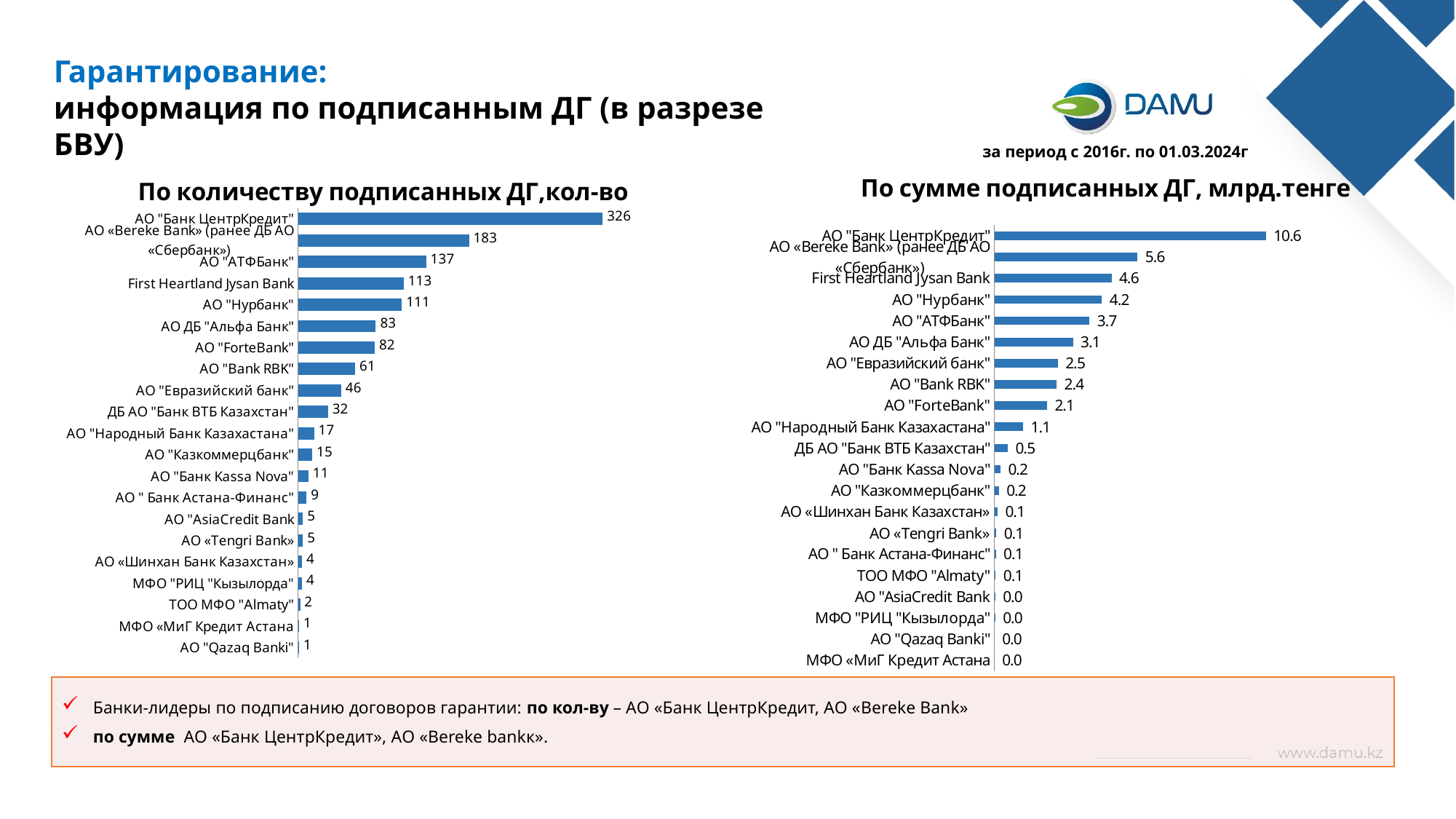
In the chart "По сумме подписанных ДГ, млрд.тенге", which is larger: АО "Евразийский банк" or АО "ForteBank"? АО "Евразийский банк" In the chart "По количеству подписанных ДГ,кол-во", what is the value for АО "АТФБанк"? 137 In the chart "По сумме подписанных ДГ, млрд.тенге", what is the value for АО "Народный Банк Казахастана"? 1.1 In the chart "По сумме подписанных ДГ, млрд.тенге", what is the difference between First Heartland Jysan Bank and АО "АТФБанк"? 0.9 In the chart "По количеству подписанных ДГ,кол-во", which is larger: АО ДБ "Альфа Банк" or АО "Bank RBK"? АО ДБ "Альфа Банк" What kind of chart is "По сумме подписанных ДГ, млрд.тенге"? Bar chart In the chart "По количеству подписанных ДГ,кол-во", what is the difference between АО "Банк ЦентрКредит" and АО «Bereke Bank» (ранее ДБ АО «Сбербанк»)? 143 In the chart "По количеству подписанных ДГ,кол-во", what is the value for ДБ АО "Банк ВТБ Казахстан"? 32 In the chart "По сумме подписанных ДГ, млрд.тенге", what is the value for АО "Нурбанк"? 4.2 In the chart "По сумме подписанных ДГ, млрд.тенге", which category has the highest value? АО "Банк ЦентрКредит" How many categories are shown in the chart "По количеству подписанных ДГ,кол-во"? 21 In the chart "По количеству подписанных ДГ,кол-во", which category has the highest value? АО "Банк ЦентрКредит"